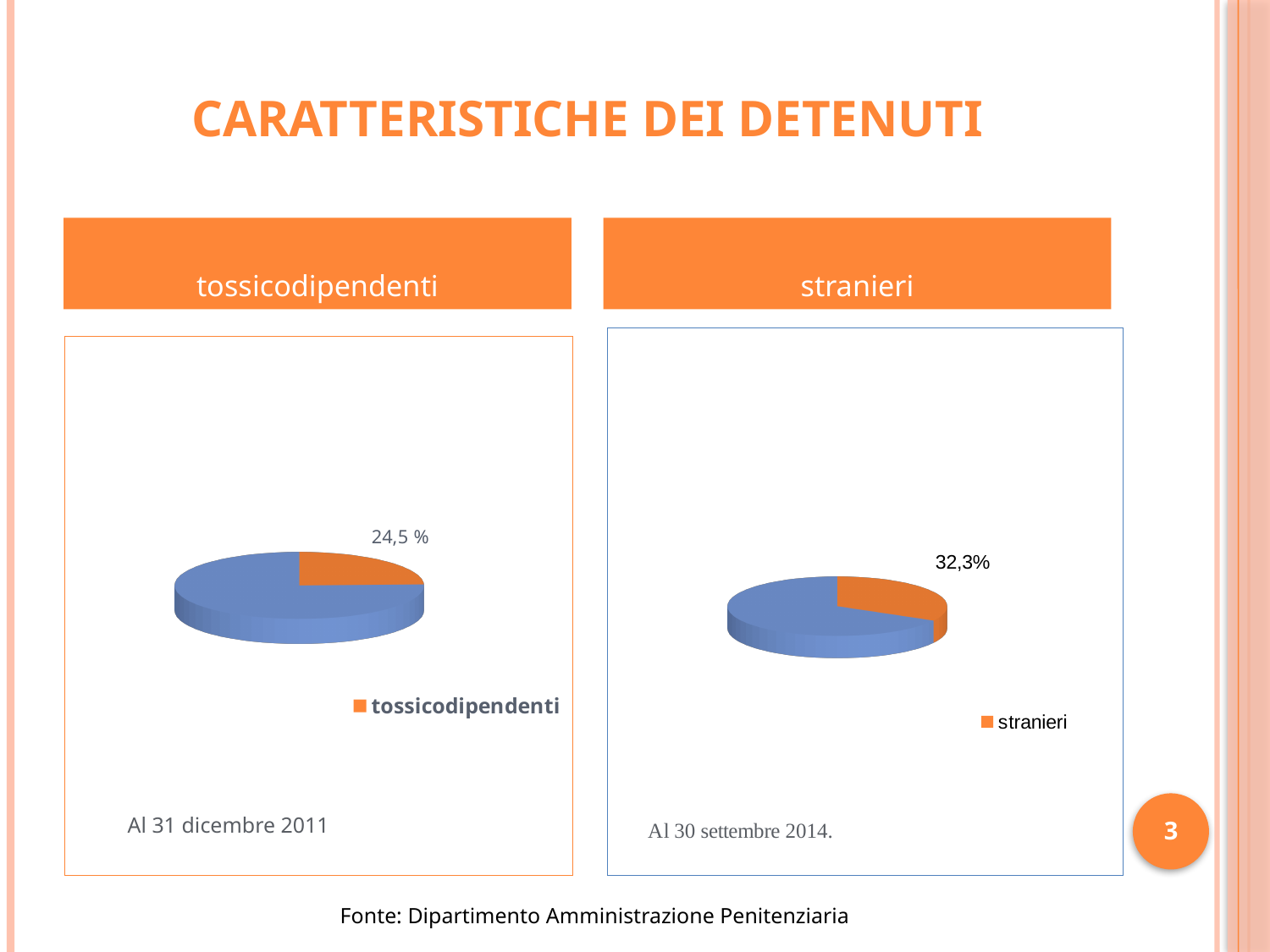
What kind of chart is the 'tossicodipendenti' chart? Pie chart In the 'tossicodipendenti' chart, what share of the pie does the orange slice represent? 24,5 % What is the difference between the stranieri percentage (32,3%) and the tossicodipendenti percentage (24,5 %)? 7,8% What kind of chart is the 'stranieri' chart? Pie chart How many entries does the legend of the 'stranieri' chart list? 1 How many slices does the 'stranieri' pie chart have? 2 How many slices does the 'tossicodipendenti' pie chart have? 2 What date is given below the 'stranieri' chart? Al 30 settembre 2014. What is the legend entry shown in the 'tossicodipendenti' chart? tossicodipendenti Which is larger: the labelled slice in the 'tossicodipendenti' chart or the labelled slice in the 'stranieri' chart? stranieri In the 'tossicodipendenti' chart, what percentage is shown for the tossicodipendenti slice? 24,5 % In the 'stranieri' chart, what percentage is shown for the stranieri slice? 32,3%